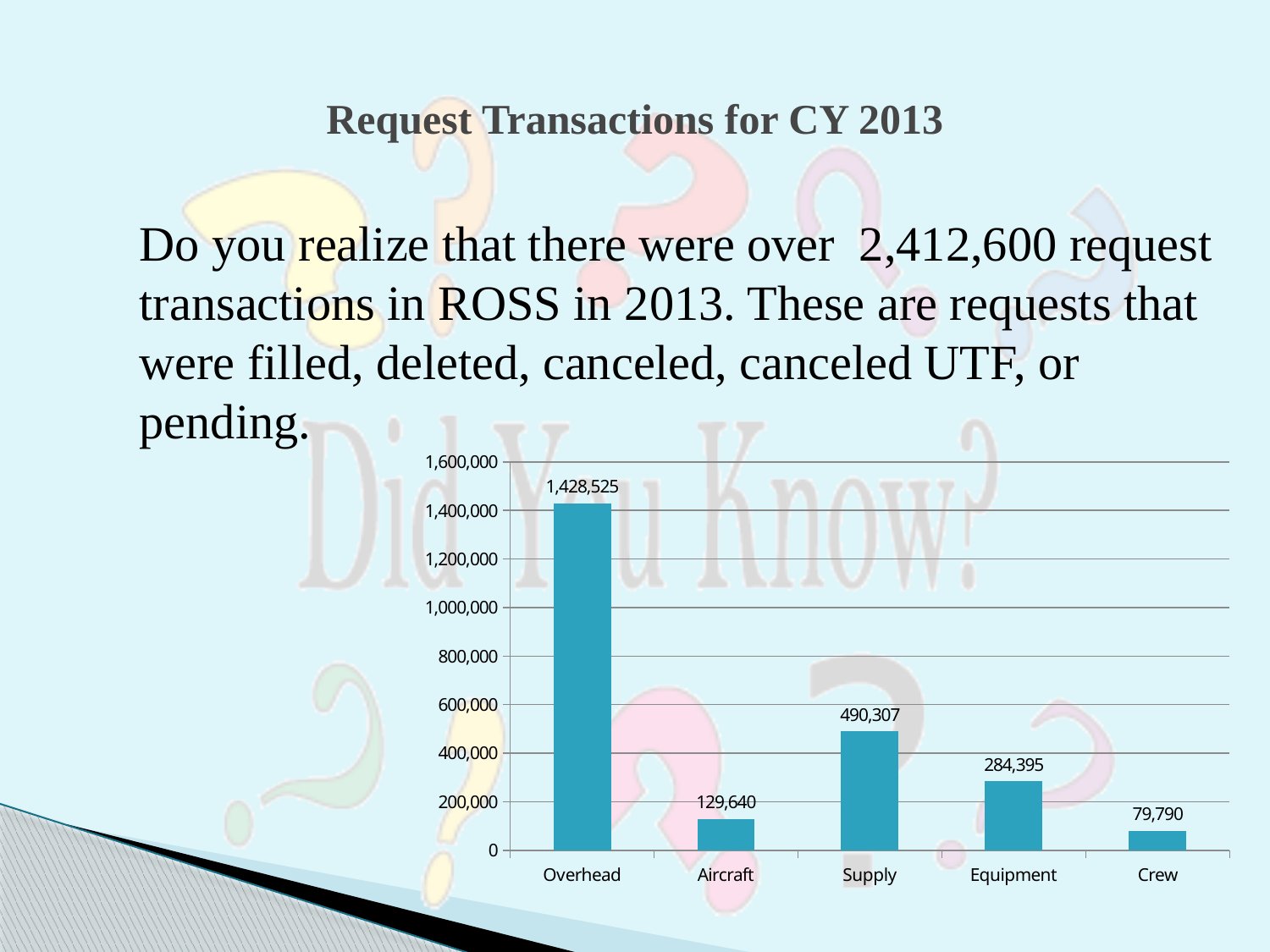
Which is larger, the value for Aircraft or the value for Equipment? Equipment What is the value for Overhead? 1,428,525 Is the value for Supply greater or less than 400,000? greater What is the difference between the values for Aircraft and Crew? 49,850 What kind of chart is shown on the slide? bar chart What is the value for Equipment? 284,395 What is the difference between the values for Supply and Equipment? 205,912 What is the value for Crew? 79,790 Which category has the highest value? Overhead Which category has the lowest value? Crew What is the value for Supply? 490,307 How many categories are shown on the x axis? 5